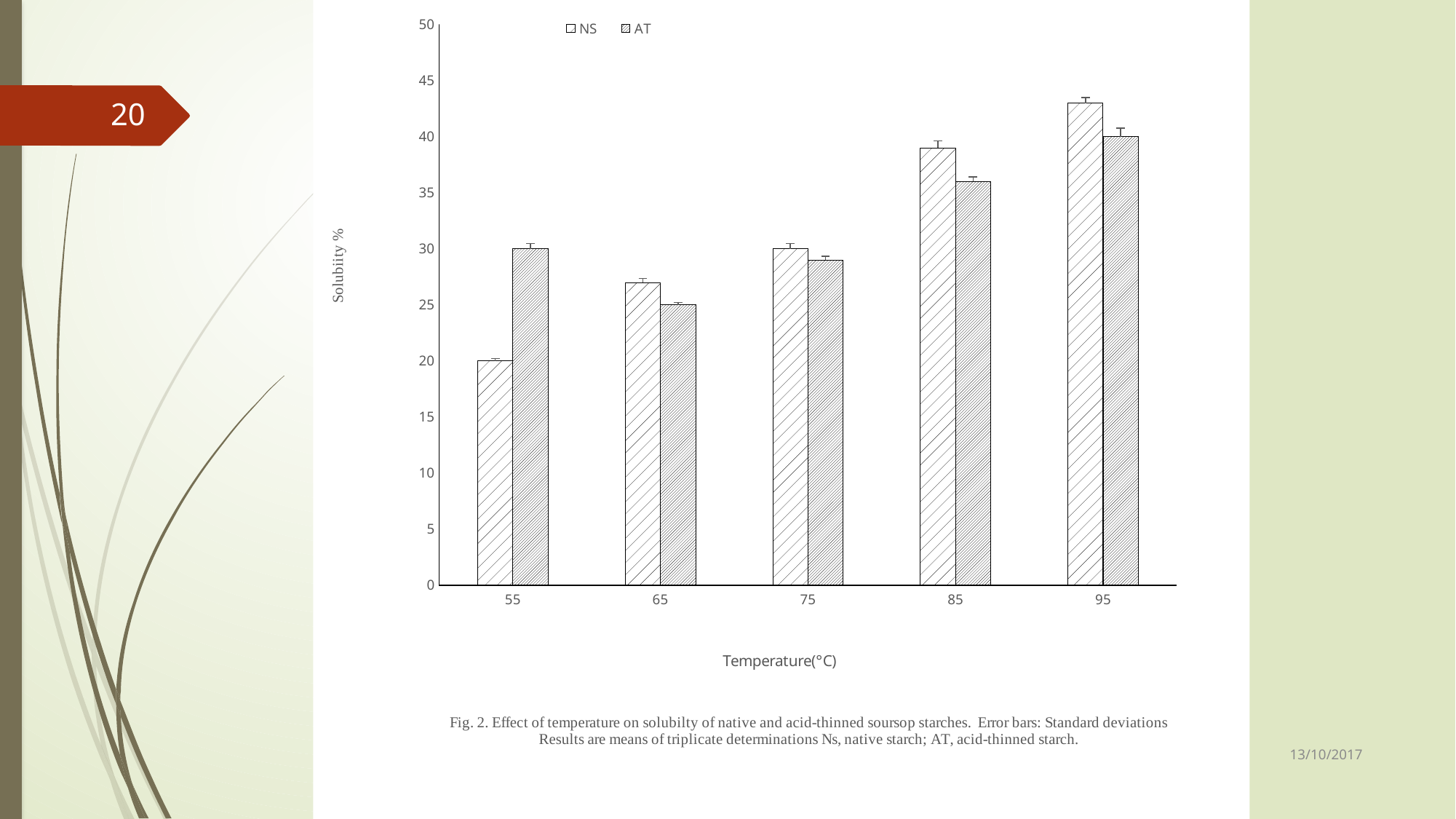
What is the solubility value for AT at 95°C? 40 At which temperature is the NS series highest? 95 Is the value for NS at 85°C greater or less than 35? greater What kind of chart is shown on the slide? bar chart What is the label of the x axis? Temperature(°C) At which temperature is the NS series lowest? 55 What is the solubility value for NS at 55°C? 20 How many series does the legend list? 2 What is the difference between the NS value at 75°C and the NS value at 55°C? 10 At 55°C, which series has the larger value, NS or AT? AT What is the solubility value for AT at 55°C? 30 How many temperature categories are shown on the x axis? 5